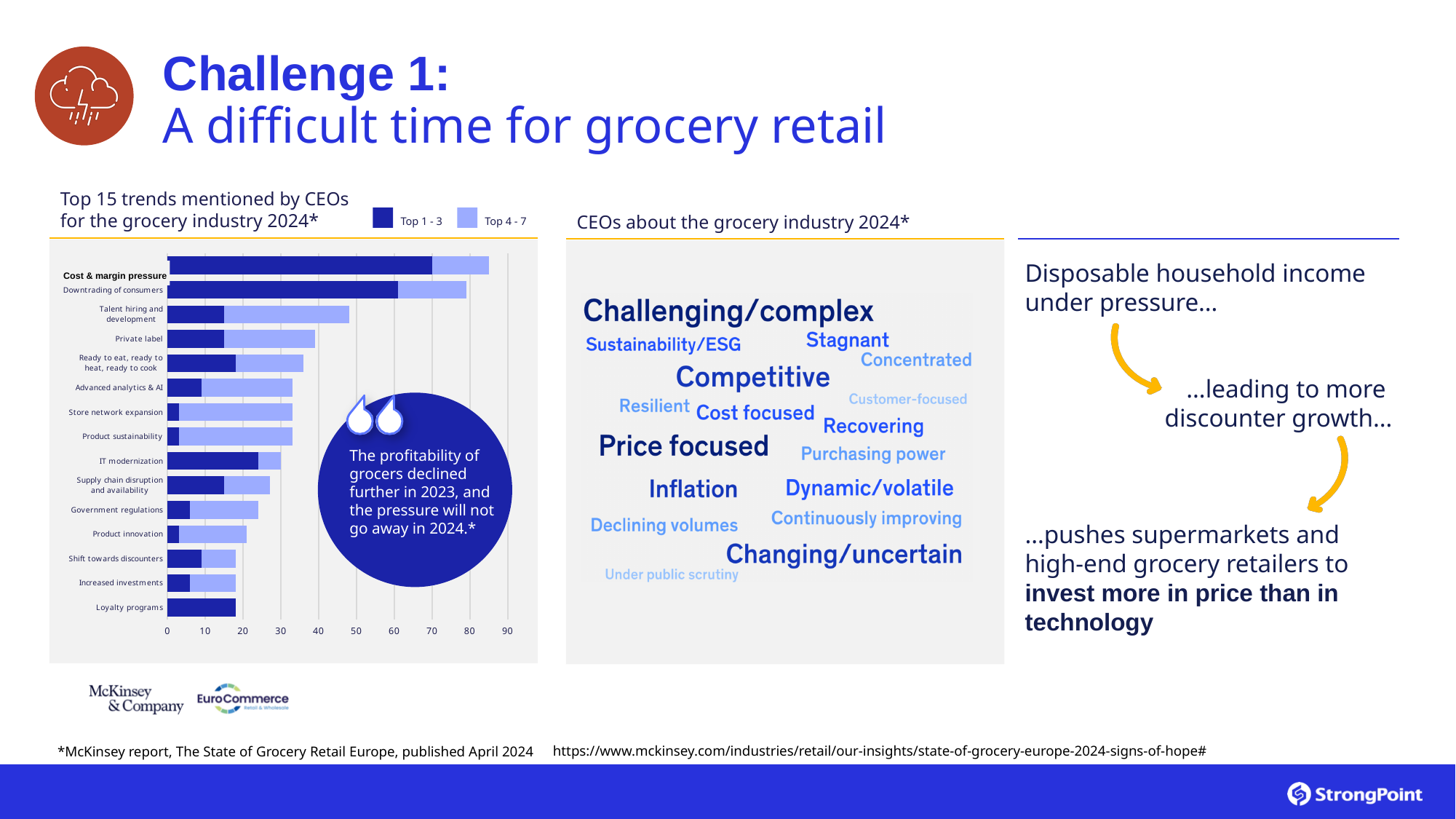
What kind of chart is used to show the top 15 trends mentioned by CEOs for the grocery industry 2024? Bar chart In the 'Top 15 trends mentioned by CEOs' chart, do the total bar lengths increase or decrease from the top category to the bottom category? Decrease How many series does the legend of the 'Top 15 trends mentioned by CEOs' chart list? 2 How many trend categories are plotted in the 'Top 15 trends mentioned by CEOs' chart? 15 Which trend has the longest total bar in the 'Top 15 trends mentioned by CEOs' chart? Cost & margin pressure In the 'Top 15 trends mentioned by CEOs' chart, is the total bar for Loyalty programs greater or less than 20? less In the 'Top 15 trends mentioned by CEOs' chart, which has the longer total bar: Talent hiring and development or Private label? Talent hiring and development In the 'Top 15 trends mentioned by CEOs' chart, which has the longer total bar: Cost & margin pressure or Downtrading of consumers? Cost & margin pressure In the 'Top 15 trends mentioned by CEOs' chart, is the total bar for Cost & margin pressure greater or less than 80? greater In the 'Top 15 trends mentioned by CEOs' chart, is the total bar for Government regulations greater or less than 30? less What are the two legend entries in the 'Top 15 trends mentioned by CEOs' chart? Top 1 - 3 and Top 4 - 7